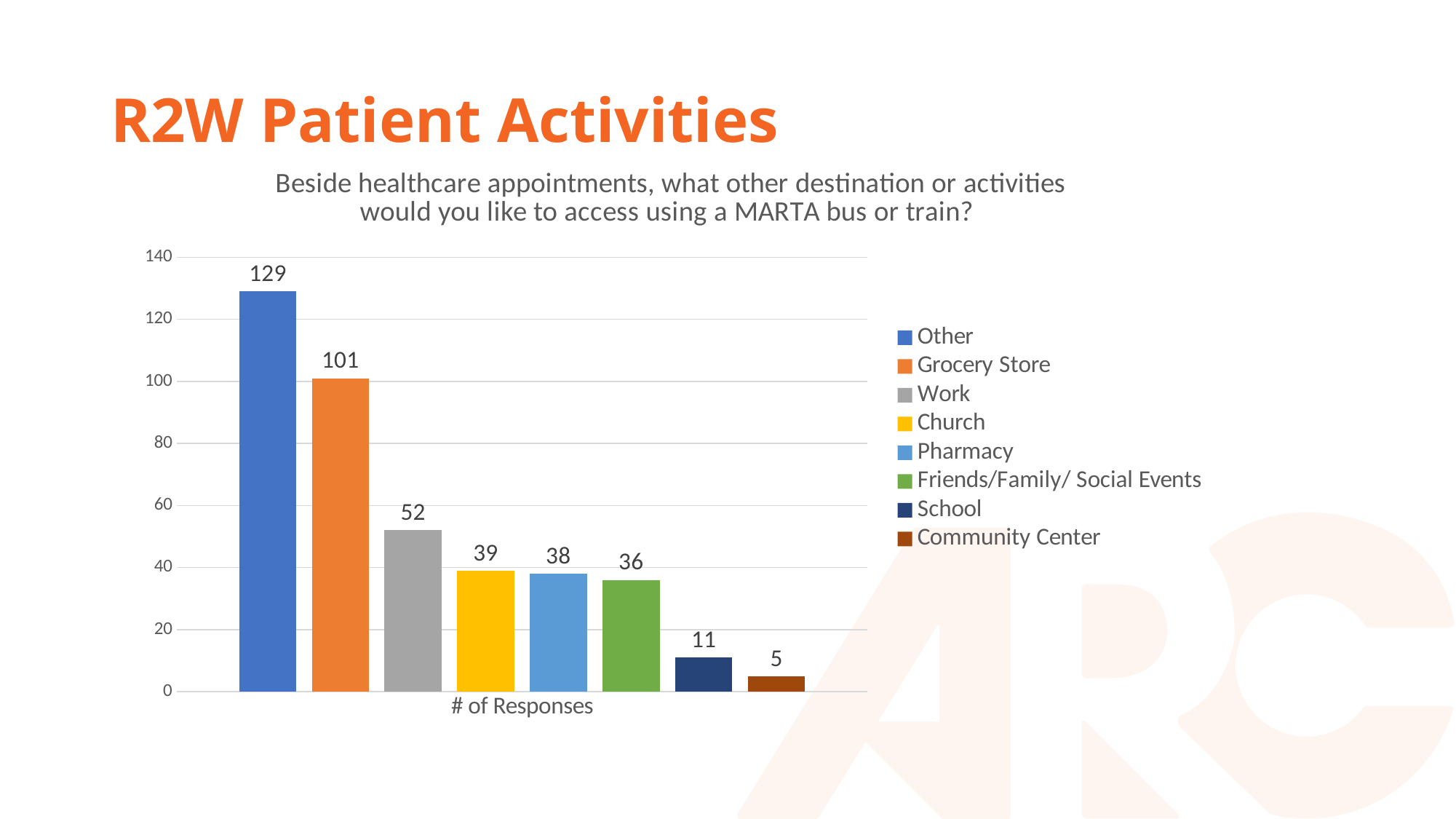
Which has more responses, Church or Friends/Family/ Social Events? Church What is the value for Pharmacy? 38 How many responses are shown for Community Center? 5 Which category has the lowest number of responses? Community Center How many series does the legend list? 8 How many responses are shown for Grocery Store? 101 What kind of chart is shown on the slide? bar chart What is the label on the x axis of the chart? # of Responses What is the difference between the values for Work and School? 41 What is the difference between the values for Other and Grocery Store? 28 Is the value for Work greater or less than 60? less Which category has the highest number of responses? Other